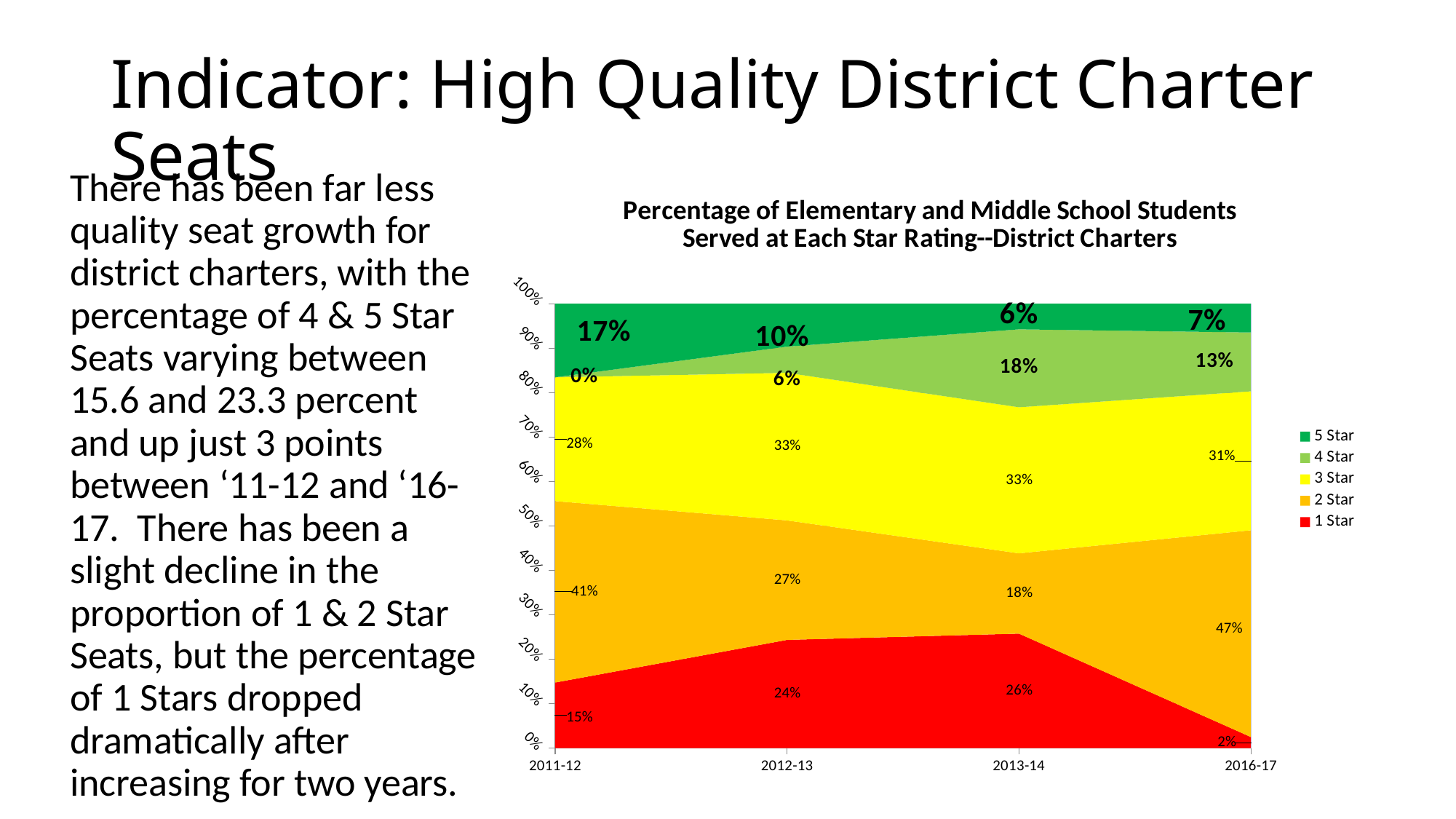
How many school years are shown on the x axis? 4 How many series does the legend list? 5 What percentage of students were served at 2 Star schools in 2011-12? 41% What kind of chart is shown on the slide? Stacked area chart In which year was the 5 Star percentage lowest? 2013-14 Which was larger in 2012-13, the 1 Star percentage or the 2 Star percentage? 2 Star What is the difference between the 2 Star percentage in 2016-17 and in 2013-14? 29% In which year was the 1 Star percentage highest? 2013-14 What percentage of students were served at 4 Star schools in 2013-14? 18% Which colour represents 3 Star in the chart? Yellow What percentage of students were served at 1 Star schools in 2016-17? 2% What percentage of students were served at 5 Star schools in 2012-13? 10%